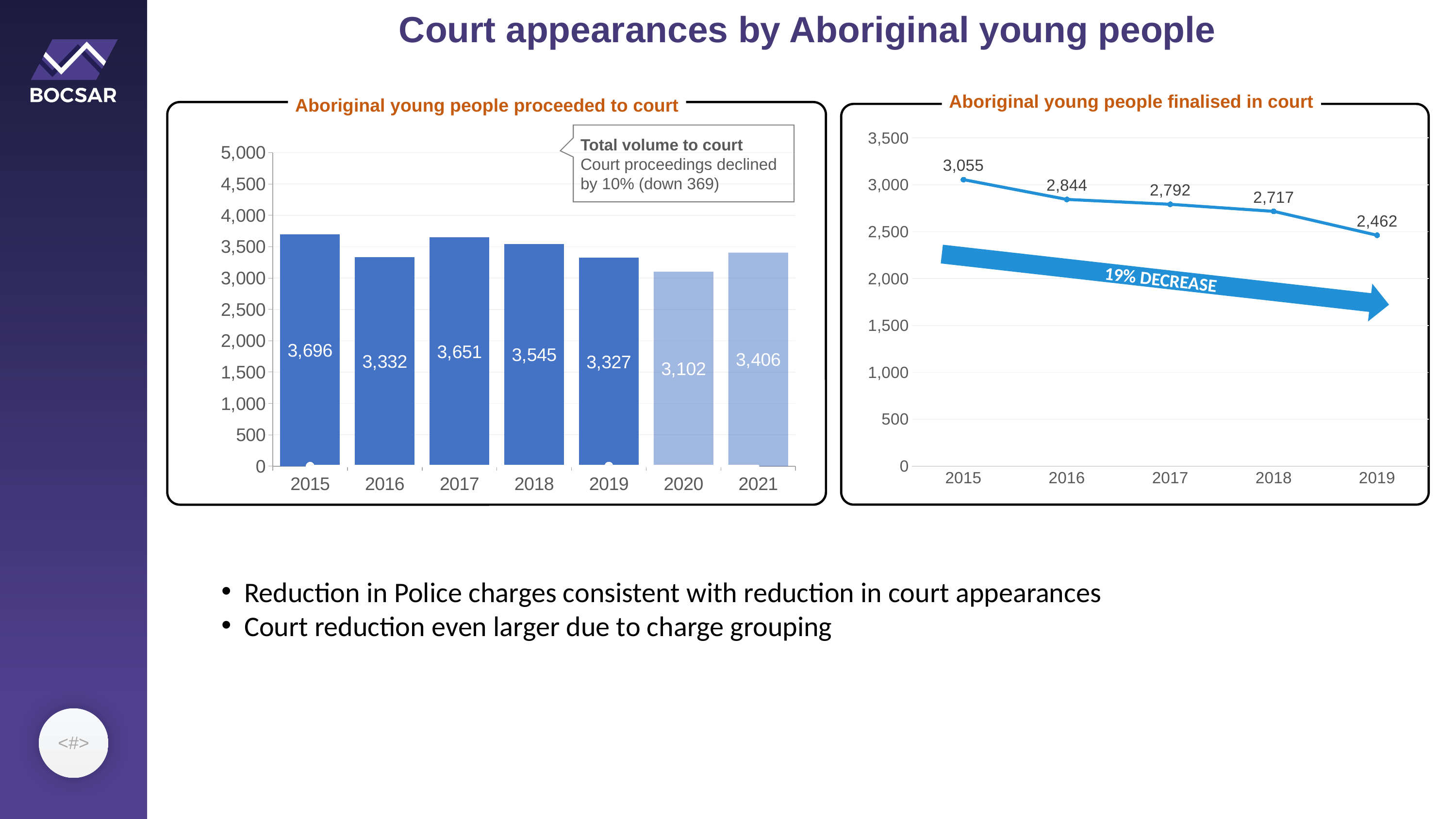
In the 'Aboriginal young people proceeded to court' chart, which year has the lowest value? 2020 In the 'Aboriginal young people proceeded to court' chart, which year has the highest value? 2015 In the 'Aboriginal young people proceeded to court' chart, how many years are shown? 7 What kind of chart is 'Aboriginal young people proceeded to court'? Bar chart In the 'Aboriginal young people proceeded to court' chart, what is the value for 2015? 3,696 In the 'Aboriginal young people finalised in court' chart, what is the value for 2017? 2,792 In the 'Aboriginal young people finalised in court' chart, what is the difference between the 2015 and 2019 values? 593 What kind of chart is 'Aboriginal young people finalised in court'? Line chart In the 'Aboriginal young people proceeded to court' chart, what is the difference between the 2017 and 2018 values? 106 In the 'Aboriginal young people finalised in court' chart, do the values rise or fall from 2015 to 2019? Fall In the 'Aboriginal young people proceeded to court' chart, what is the value for 2020? 3,102 In the 'Aboriginal young people finalised in court' chart, what is the value for 2019? 2,462